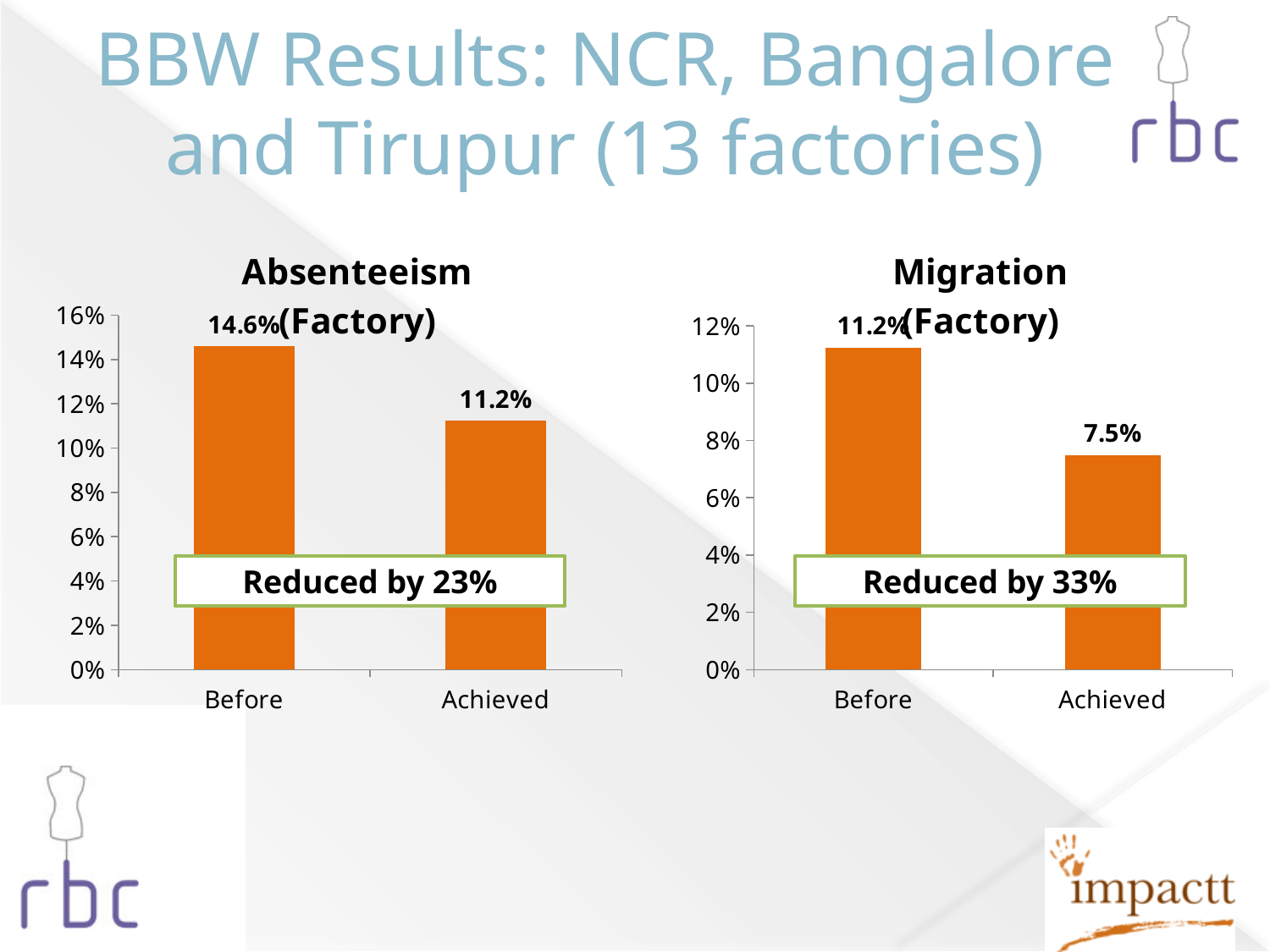
In the Migration (Factory) chart, what is the value for Achieved? 7.5% According to the text box on the Migration (Factory) chart, by what percentage was migration reduced? 33% In the Migration (Factory) chart, is the value for Before greater or less than 10%? greater In the Absenteeism (Factory) chart, what is the difference between the Before and Achieved values? 3.4% In the Migration (Factory) chart, which category has the lowest value? Achieved In the Absenteeism (Factory) chart, what is the value for Before? 14.6% In the Absenteeism (Factory) chart, what is the value for Achieved? 11.2% In the Migration (Factory) chart, what is the difference between the Before and Achieved values? 3.7% In the Migration (Factory) chart, what is the value for Before? 11.2% How many categories are shown in the Absenteeism (Factory) chart? 2 What kind of chart is the Migration (Factory) chart? Bar chart In the Absenteeism (Factory) chart, which category has the highest value? Before